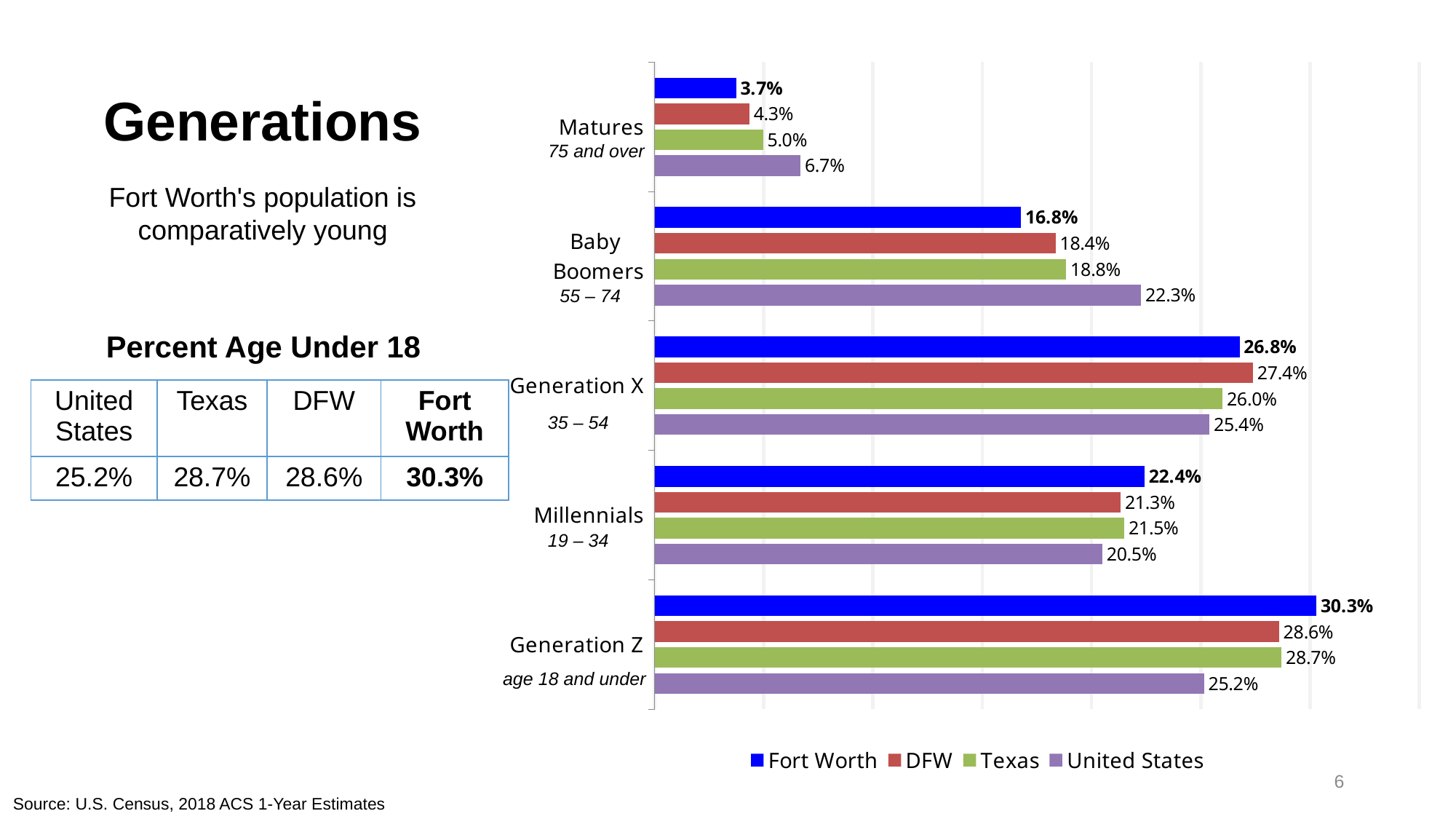
What is the difference between the Fort Worth and United States values for Generation Z? 5.1% How many series does the legend list? 4 Which generation has the lowest United States value? Matures What is the Fort Worth value for Generation Z? 30.3% What is the Texas value for Millennials? 21.5% How many generation categories are shown in the chart? 5 What is the DFW value for Matures? 4.3% What kind of chart is shown on the slide? Bar chart Which is larger for Generation X, the DFW value or the Fort Worth value? DFW Which colour represents Fort Worth in the chart? Blue Which generation has the highest Fort Worth value? Generation Z What is the United States value for Baby Boomers? 22.3%